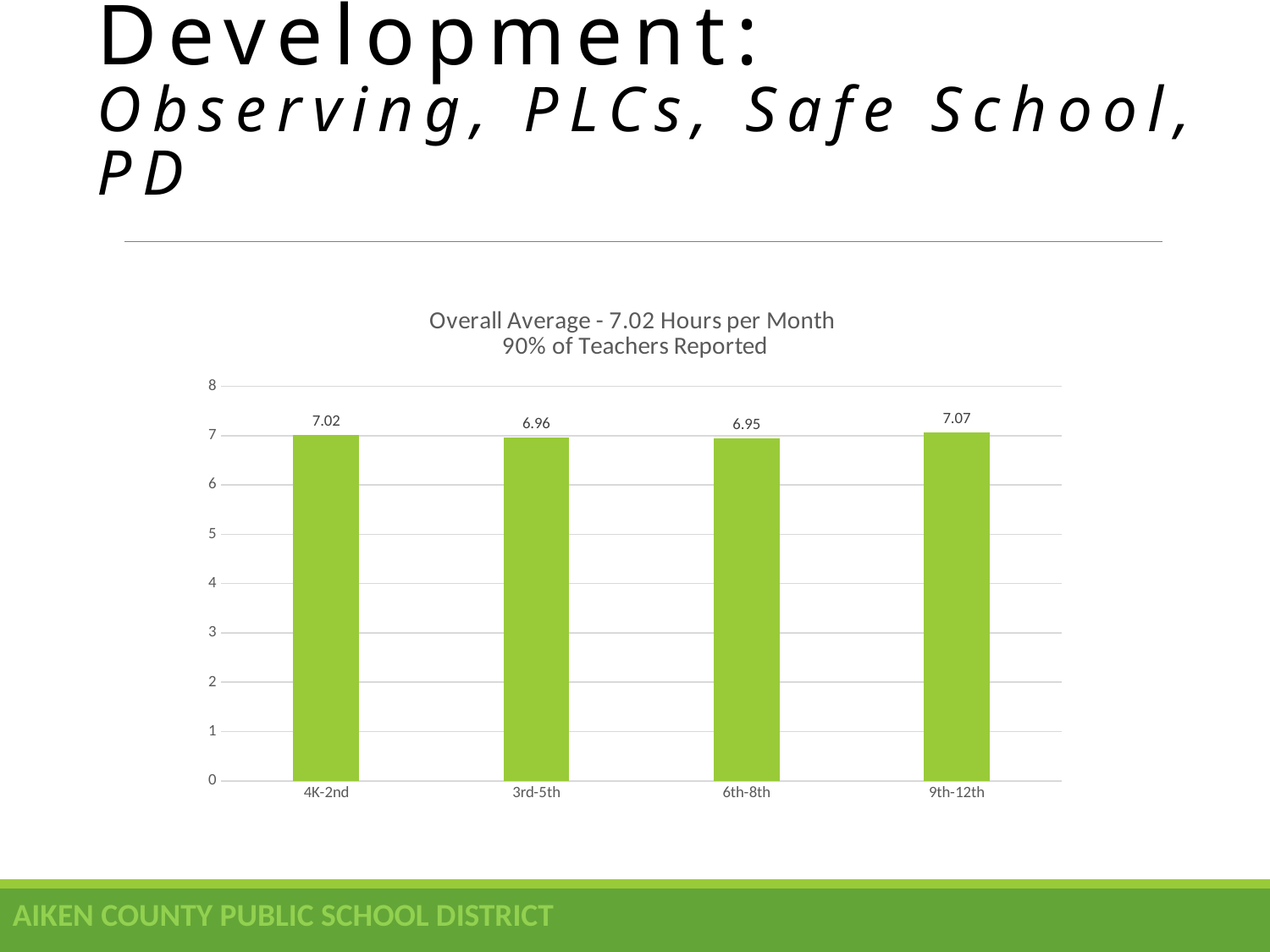
What is the value for 4K-2nd? 7.02 What overall average is stated in the chart title? 7.02 Hours per Month Which is larger, the value for 4K-2nd or the value for 3rd-5th? 4K-2nd What is the difference between the values for 9th-12th and 6th-8th? 0.12 What kind of chart is shown on the slide? bar chart What is the value for 3rd-5th? 6.96 What is the value for 9th-12th? 7.07 Is the value for 6th-8th greater or less than 6? greater How many grade bands are shown on the chart? 4 What is the value for 6th-8th? 6.95 Which grade band has the lowest value? 6th-8th Which grade band has the highest value? 9th-12th